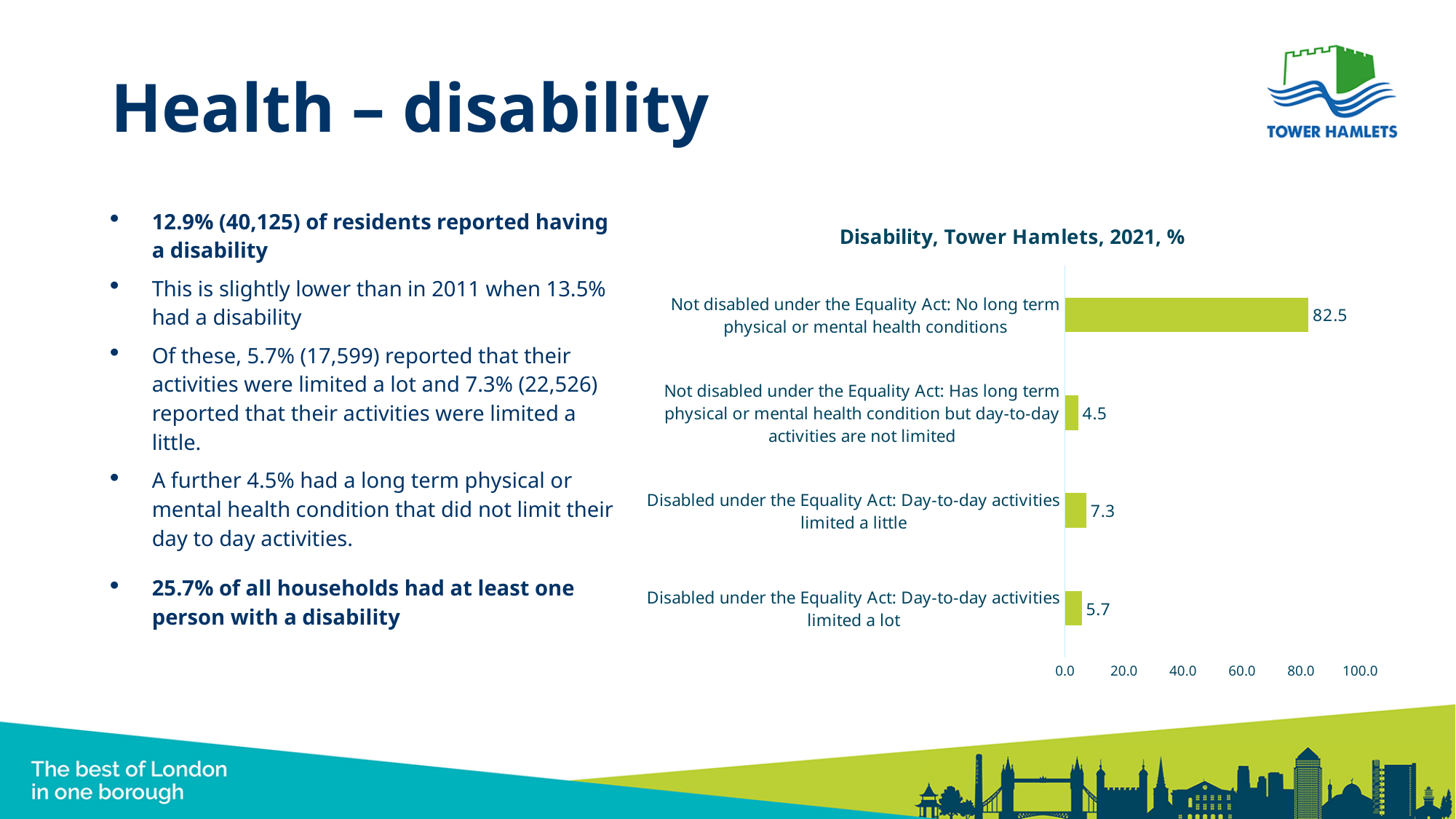
What is the value for 'Disabled under the Equality Act: Day-to-day activities limited a lot'? 5.7 What is the title of the chart? Disability, Tower Hamlets, 2021, % Is the value for 'Not disabled under the Equality Act: No long term physical or mental health conditions' greater or less than 80.0? greater What is the difference between the value for 'Day-to-day activities limited a little' and 'Day-to-day activities limited a lot'? 1.6 What is the value for 'Disabled under the Equality Act: Day-to-day activities limited a little'? 7.3 What is the value for 'Not disabled under the Equality Act: No long term physical or mental health conditions'? 82.5 Which is larger: the value for 'Day-to-day activities limited a lot' or 'Has long term physical or mental health condition but day-to-day activities are not limited'? Day-to-day activities limited a lot What is the value for 'Not disabled under the Equality Act: Has long term physical or mental health condition but day-to-day activities are not limited'? 4.5 What kind of chart is shown on the slide? bar chart Which category has the highest value? Not disabled under the Equality Act: No long term physical or mental health conditions How many categories are shown in the chart? 4 Which category has the lowest value? Not disabled under the Equality Act: Has long term physical or mental health condition but day-to-day activities are not limited